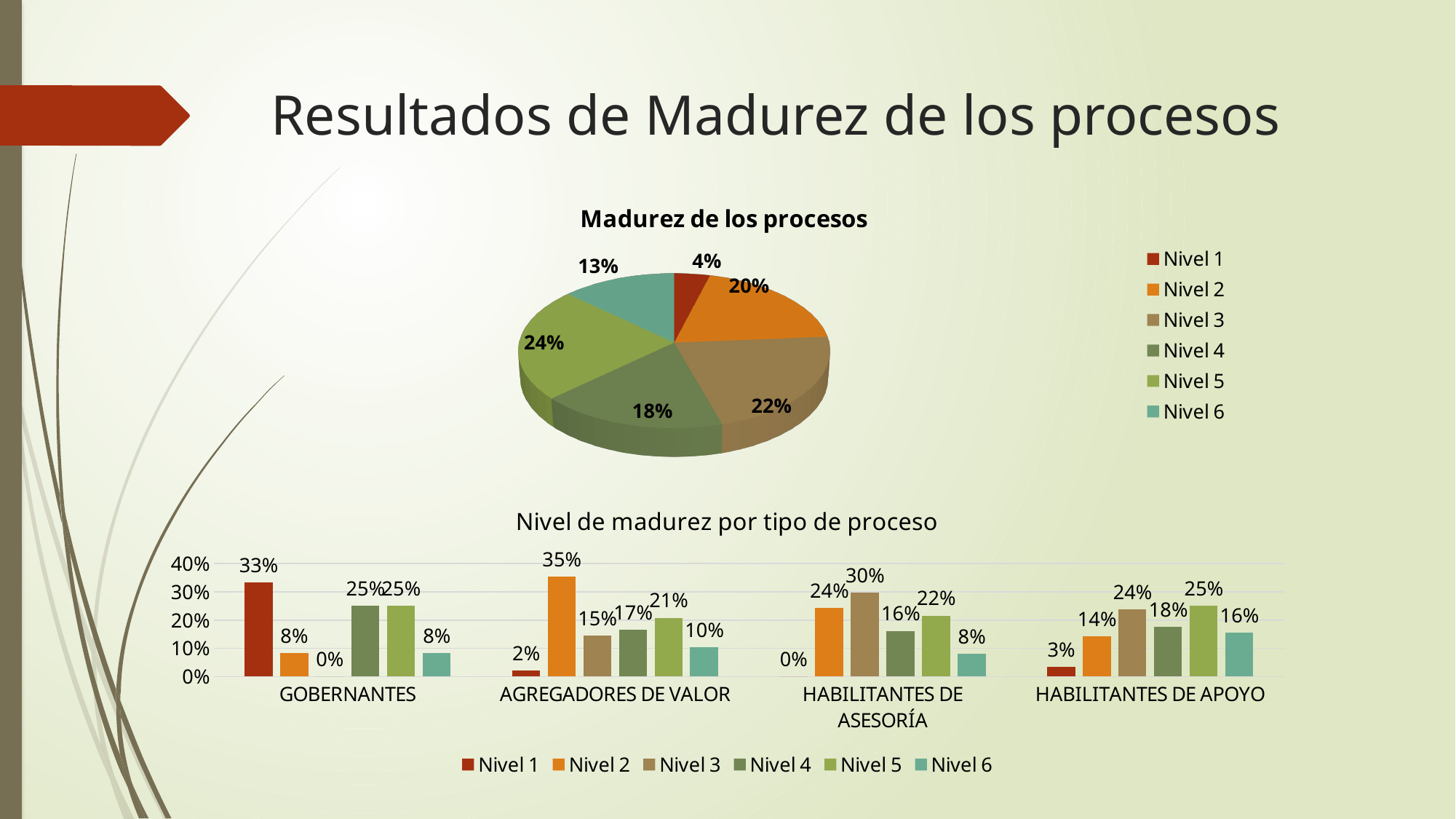
How many process types (categories) are shown on the x axis of the chart 'Nivel de madurez por tipo de proceso'? 4 In the chart 'Nivel de madurez por tipo de proceso', which level has the highest value for GOBERNANTES? Nivel 1 In the pie chart 'Madurez de los procesos', what share does Nivel 5 have? 24% In the pie chart 'Madurez de los procesos', which level has the smallest slice? Nivel 1 What type of chart is 'Nivel de madurez por tipo de proceso'? Bar chart In the chart 'Nivel de madurez por tipo de proceso', what is the value of Nivel 3 for HABILITANTES DE ASESORÍA? 30% In the chart 'Nivel de madurez por tipo de proceso', what is the value of Nivel 2 for AGREGADORES DE VALOR? 35% In the pie chart 'Madurez de los procesos', which level has the largest slice? Nivel 5 How many series does the legend of the pie chart 'Madurez de los procesos' list? 6 In the pie chart 'Madurez de los procesos', what is the difference between the Nivel 3 and Nivel 6 shares? 9% In the chart 'Nivel de madurez por tipo de proceso', which is larger for HABILITANTES DE APOYO: Nivel 3 or Nivel 4? Nivel 3 In the chart 'Nivel de madurez por tipo de proceso', what is the difference between Nivel 1 for GOBERNANTES and Nivel 1 for HABILITANTES DE APOYO? 30%